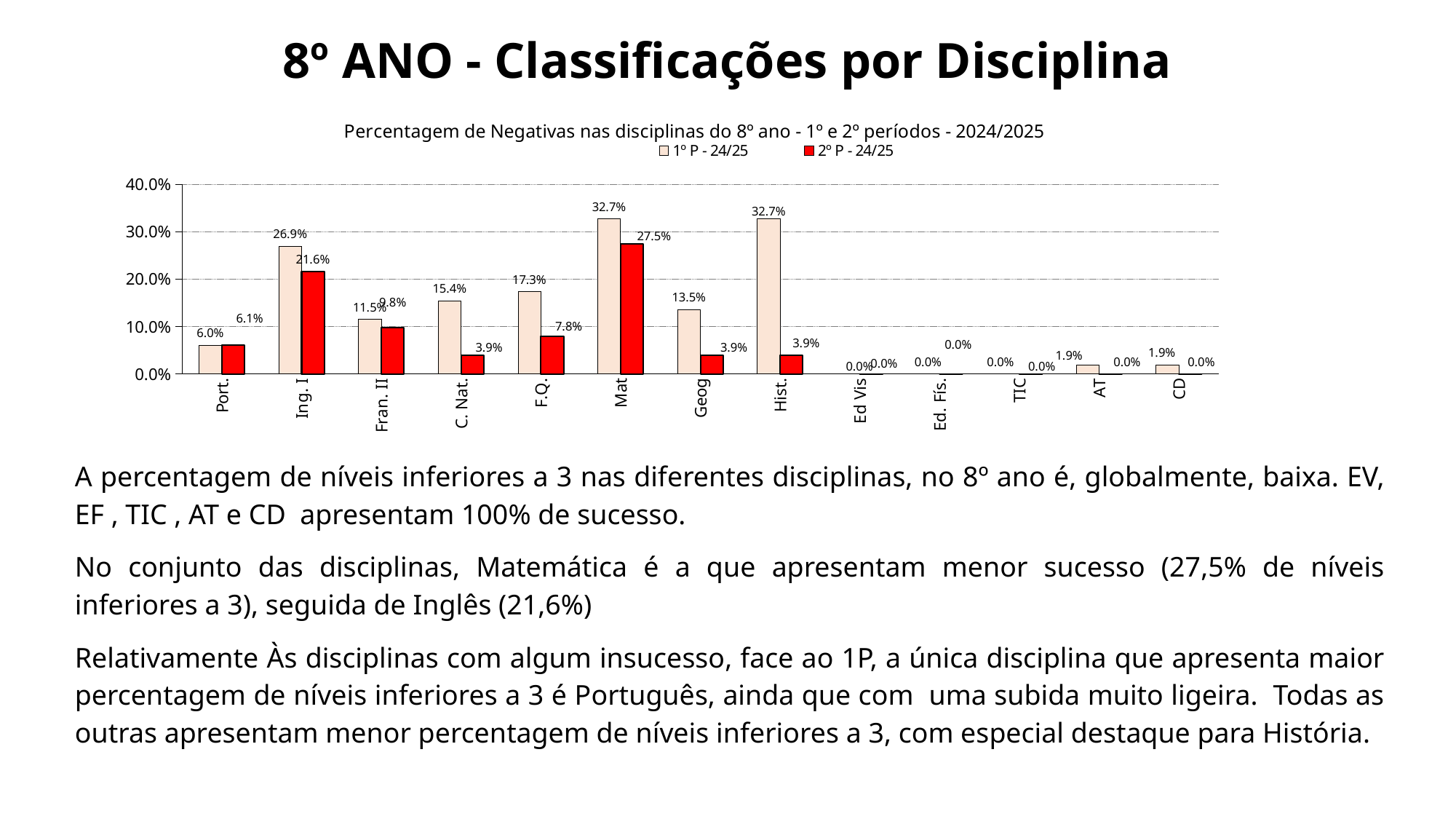
How many series does the legend list? 2 What is the difference between the 1º P - 24/25 and 2º P - 24/25 values for Hist.? 28.8% Which is larger for Geog: the 1º P - 24/25 value or the 2º P - 24/25 value? 1º P - 24/25 How many categories are shown on the x axis? 13 What is the value for Mat in the 2º P - 24/25 series? 27.5% What is the difference between the 1º P - 24/25 and 2º P - 24/25 values for C. Nat.? 11.5% What is the value for Hist. in the 1º P - 24/25 series? 32.7% Which category has the highest value in the 2º P - 24/25 series? Mat What is the value for Ing. I in the 2º P - 24/25 series? 21.6% What kind of chart is shown on the slide? bar chart What is the value for F.Q. in the 1º P - 24/25 series? 17.3% Is the 1º P - 24/25 value for Ing. I greater or less than 20.0%? greater